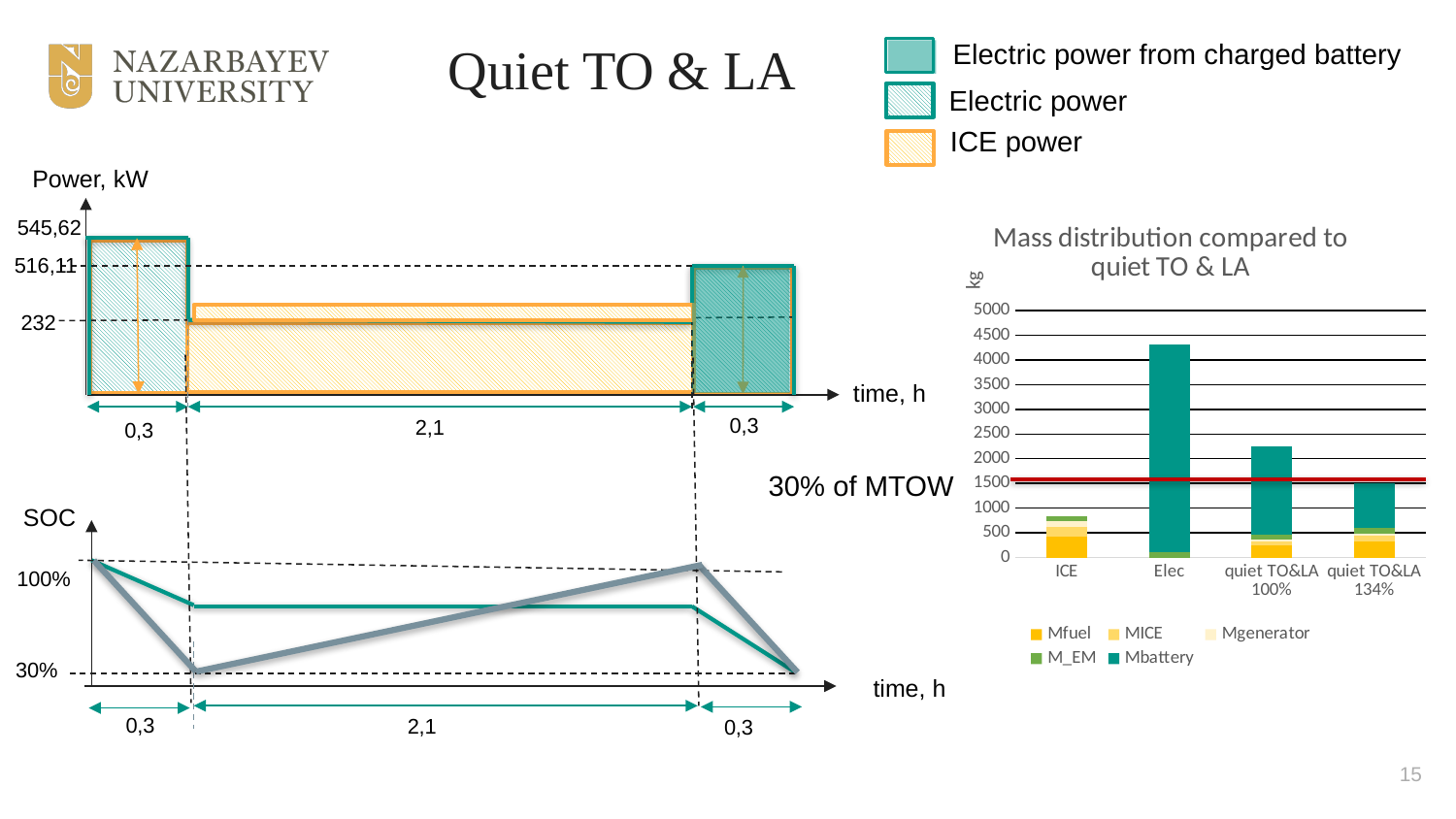
In the 'Mass distribution compared to quiet TO & LA' chart, is the total for ICE greater or less than 1000? less In the 'Mass distribution compared to quiet TO & LA' chart, how many series does the legend list? 5 In the 'Mass distribution compared to quiet TO & LA' chart, is the total for quiet TO&LA 100% greater or less than 2000? greater In the 'Mass distribution compared to quiet TO & LA' chart, is the total for Elec greater or less than 4000? greater In the 'Mass distribution compared to quiet TO & LA' chart, which category has the tallest stacked bar? Elec In the 'Mass distribution compared to quiet TO & LA' chart, which stacked bar is taller: quiet TO&LA 100% or quiet TO&LA 134%? quiet TO&LA 100% In the 'Mass distribution compared to quiet TO & LA' chart, which series is shown in dark teal in the legend? Mbattery In the power-versus-time diagram on the left, what is the highest power value labelled on the Power, kW axis? 545,62 In the 'Mass distribution compared to quiet TO & LA' chart, what unit is shown on the y axis? kg In the 'Mass distribution compared to quiet TO & LA' chart, which category has the shortest stacked bar? ICE What type of chart is the 'Mass distribution compared to quiet TO & LA' chart? bar chart In the 'Mass distribution compared to quiet TO & LA' chart, how many categories are shown on the x axis? 4